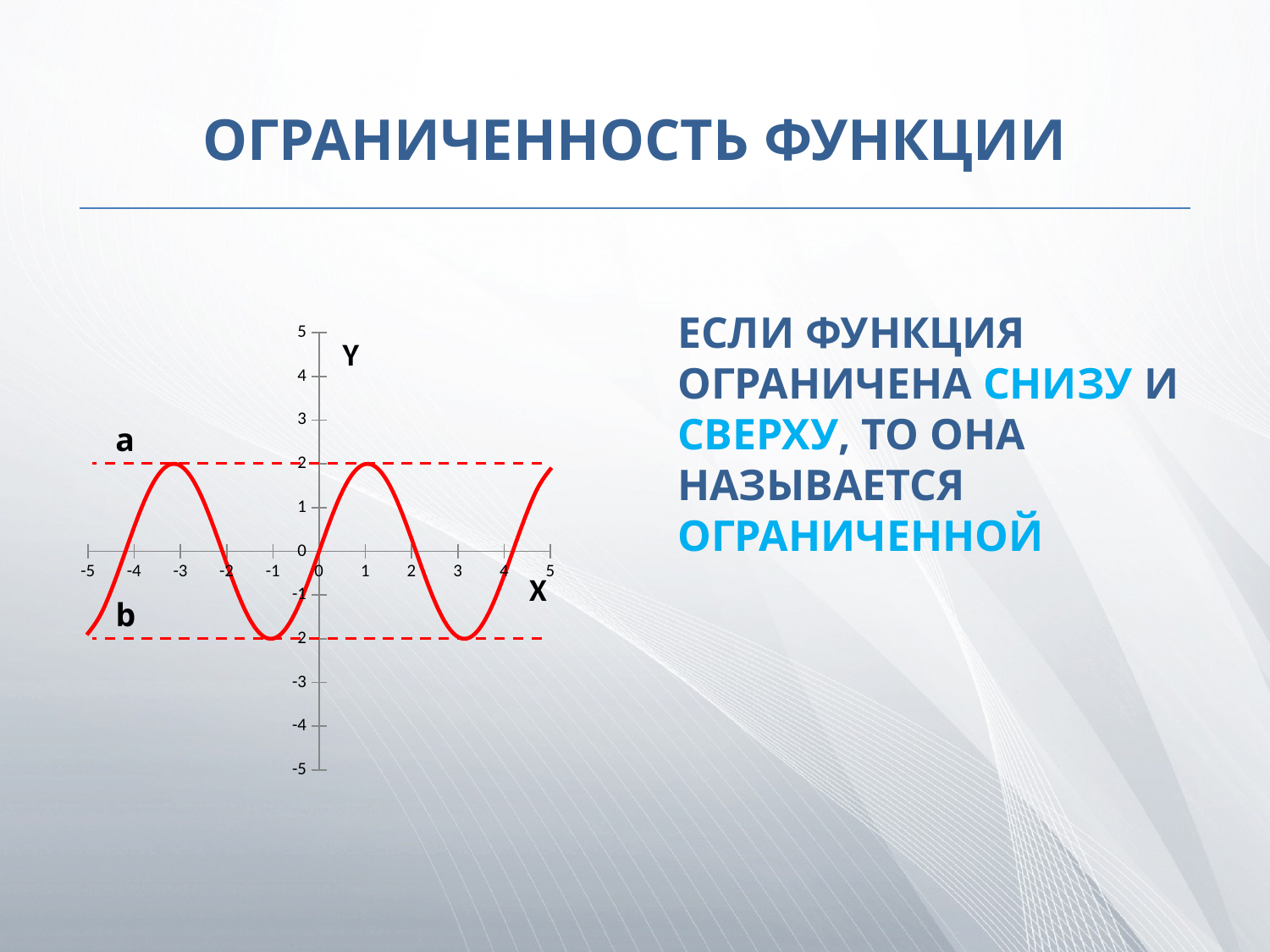
Is the value of the curve at x = 1 greater or less than 1? greater At what y value is the dashed line labelled a drawn? 2 How many peaks (maximum points) of the curve are visible on the chart? 2 What is the difference between the y values of the dashed lines a and b? 4 What is the lowest value the red curve reaches on the y axis? -2 At what y value is the dashed line labelled b drawn? -2 Does the curve rise or fall as x goes from 1 to 3? falls What is the highest value the red curve reaches on the y axis? 2 Does the curve rise or fall as x goes from 0 to 1? rises What colour is the plotted curve? red What kind of chart is shown on the slide? line chart Is the value of the curve at x = 3 greater or less than -1? less